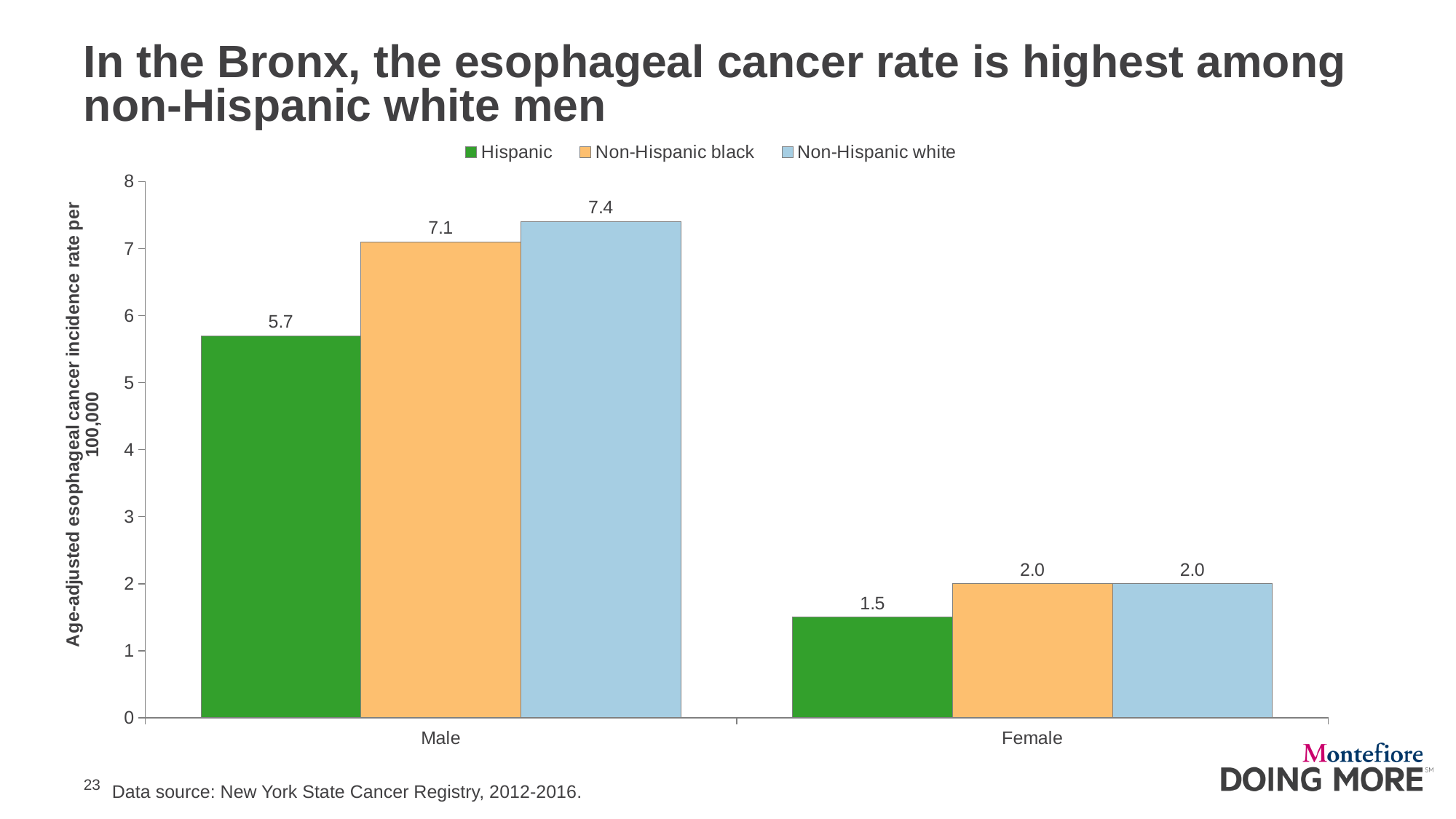
Which is larger, the esophageal cancer incidence rate for non-Hispanic black males or for Hispanic males? Non-Hispanic black males Which group has the highest esophageal cancer incidence rate among males? Non-Hispanic white What is the esophageal cancer incidence rate for Hispanic females? 1.5 What kind of chart is shown on the slide? Bar chart What colour represents the Hispanic series in the chart? Green What is the difference between the esophageal cancer incidence rates for non-Hispanic white males and Hispanic males? 1.7 Is the esophageal cancer incidence rate for non-Hispanic black males greater or less than 6? greater How many series does the legend list? 3 What is the esophageal cancer incidence rate for non-Hispanic white males? 7.4 Which group has the lowest esophageal cancer incidence rate among females? Hispanic What is the esophageal cancer incidence rate for non-Hispanic black females? 2.0 What is the age-adjusted esophageal cancer incidence rate per 100,000 for Hispanic males? 5.7